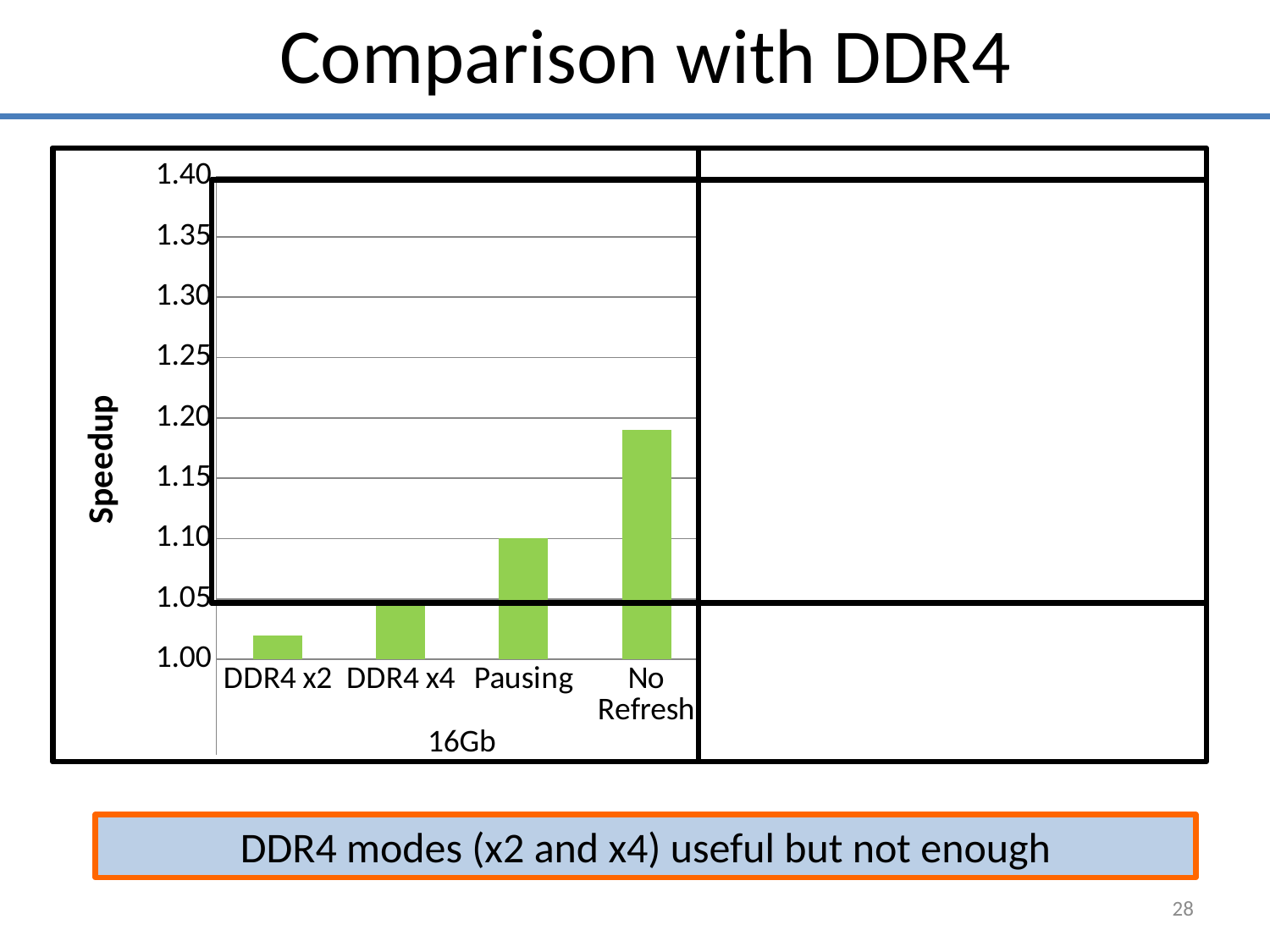
What kind of chart is shown on the slide? bar chart Is the speedup for No Refresh greater or less than 1.20? less What group label appears below the category names on the x axis? 16Gb How many bars (categories) are plotted in the chart? 4 What is the label on the vertical axis of the chart? Speedup Do the speedup values rise or fall moving left to right across the categories? rise Is the speedup for No Refresh greater or less than 1.15? greater Is the speedup for DDR4 x2 greater or less than 1.05? less Which category has the highest speedup? No Refresh Which category has the lowest speedup? DDR4 x2 Which has a larger speedup, Pausing or DDR4 x2? Pausing